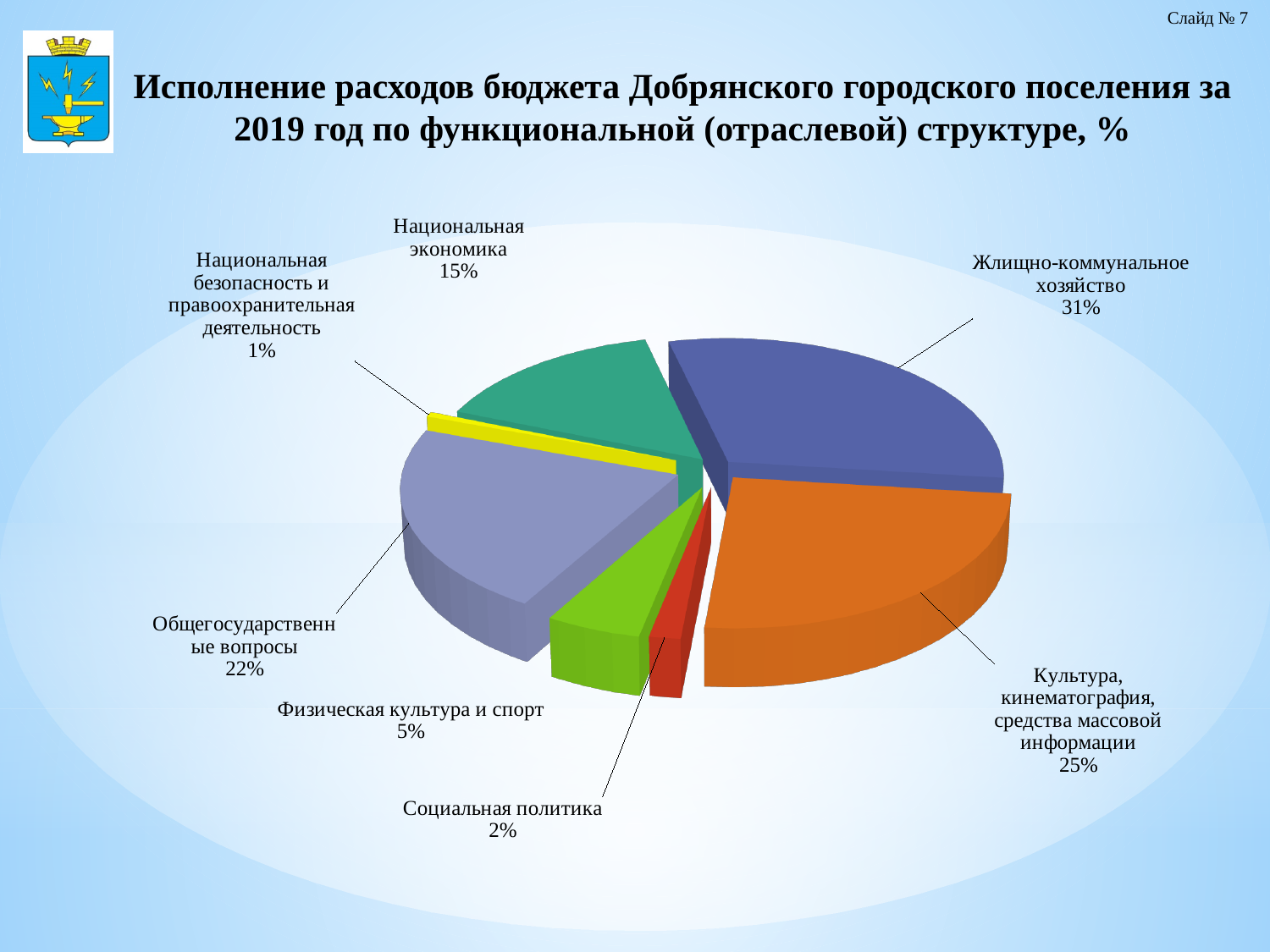
What kind of chart is shown on the slide? Pie chart Which category has the smallest share of the pie? Национальная безопасность и правоохранительная деятельность What is the value shown for Национальная экономика? 15% What share of the pie does Жилищно-коммунальное хозяйство have? 31% Which category has the largest share of the pie? Жилищно-коммунальное хозяйство What colour is the slice for Культура, кинематография, средства массовой информации? Orange Which is larger: Общегосударственные вопросы or Национальная экономика? Общегосударственные вопросы What is the difference in percentage points between Физическая культура и спорт and Социальная политика? 3 How many categories are shown in the pie chart? 7 What is the value shown for Социальная политика? 2% What is the difference in percentage points between Жилищно-коммунальное хозяйство and Культура, кинематография, средства массовой информации? 6 What is the value shown for Общегосударственные вопросы? 22%